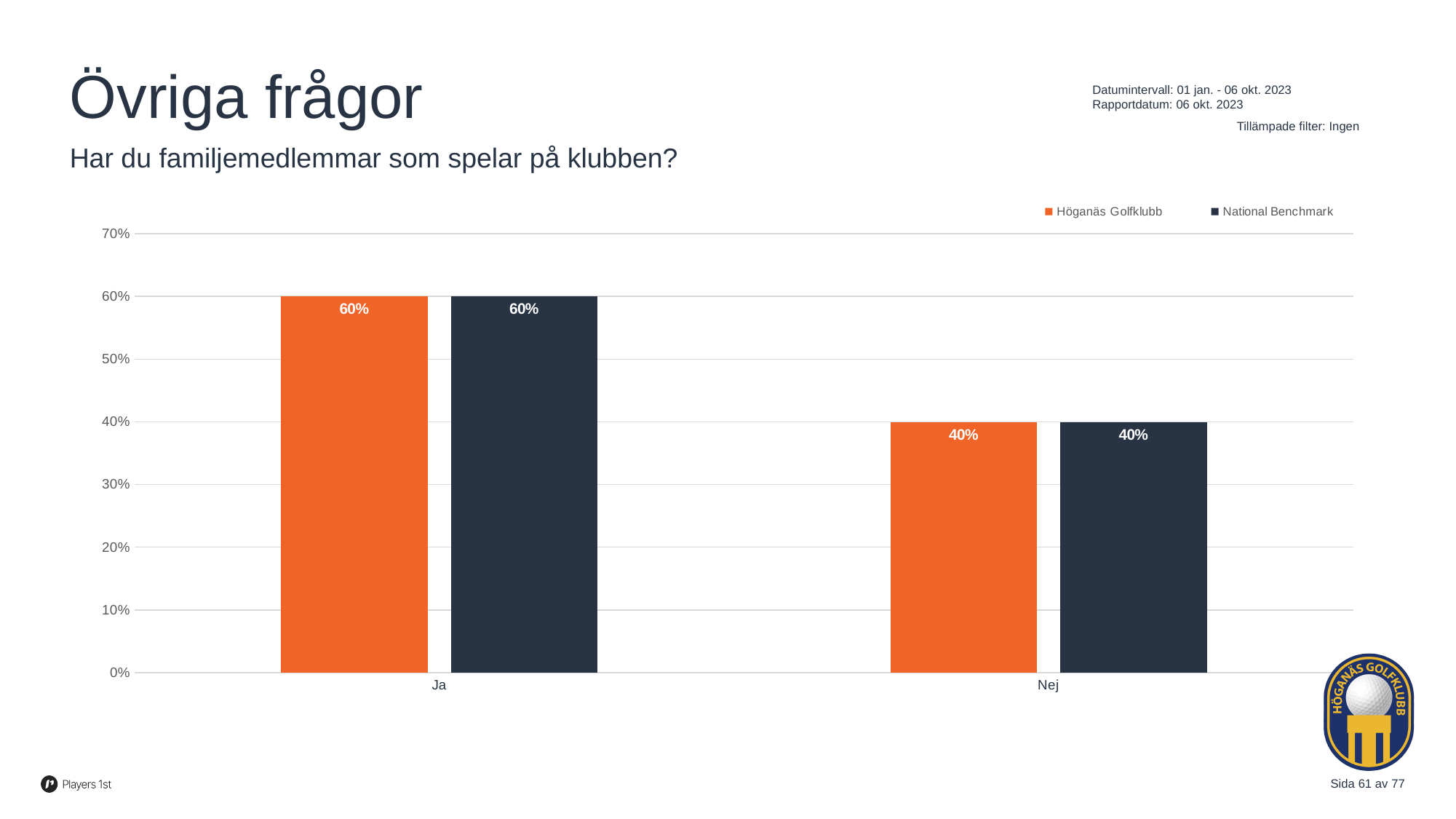
What is the value for Höganäs Golfklubb in the Nej category? 40% What is the value for National Benchmark in the Nej category? 40% Which category has the lowest value for National Benchmark? Nej How many series does the legend list? 2 What kind of chart is shown on the slide? Bar chart What is the difference between the Höganäs Golfklubb values for Ja and Nej? 20% Which is larger for Höganäs Golfklubb: Ja or Nej? Ja Which category has the highest value for Höganäs Golfklubb? Ja What is the value for National Benchmark in the Ja category? 60% What is the value for Höganäs Golfklubb in the Ja category? 60% What colour are the Höganäs Golfklubb bars? Orange How many categories are shown on the x axis? 2